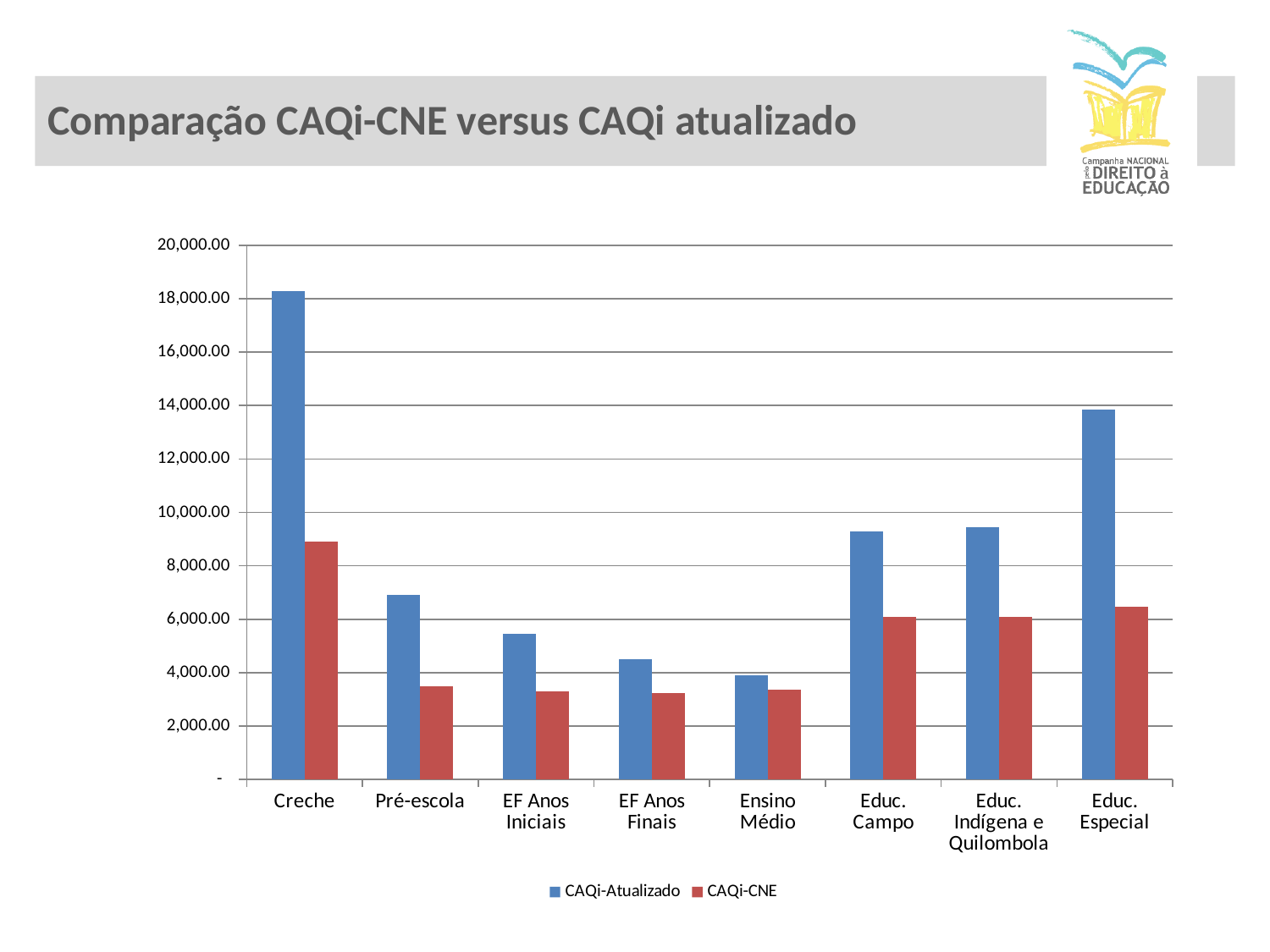
Which is larger for Educ. Especial, the CAQi-Atualizado value or the CAQi-CNE value? CAQi-Atualizado Is the CAQi-Atualizado value for Educ. Especial greater or less than 12,000.00? greater Which category has the lowest CAQi-Atualizado value? Ensino Médio Is the CAQi-CNE value for Creche greater or less than 10,000.00? less What is the title of the slide containing the chart? Comparação CAQi-CNE versus CAQi atualizado How many categories are shown on the x axis? 8 Which category has the highest CAQi-Atualizado value? Creche Which category has the highest CAQi-CNE value? Creche What kind of chart is shown on the slide? bar chart How many series does the legend list? 2 Is the CAQi-CNE value for Educ. Campo greater or less than 4,000.00? greater